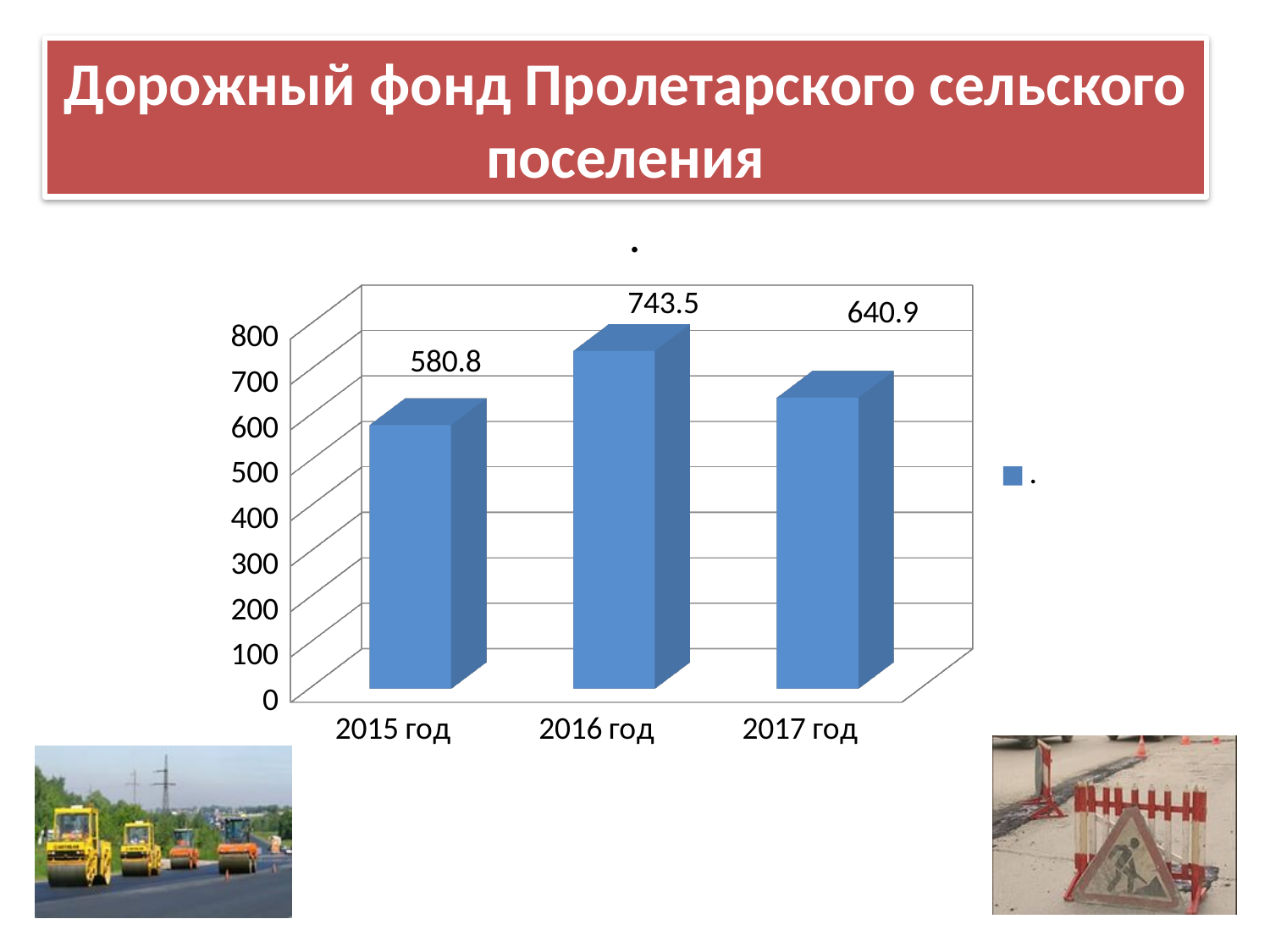
What is the difference between the values for 2016 год and 2017 год? 102.6 Which year has the lowest value? 2015 год Is the value for 2016 год greater or less than 700? greater Which year has the highest value? 2016 год What is the title of the slide? Дорожный фонд Пролетарского сельского поселения What is the value for 2017 год? 640.9 Which is larger, the value for 2017 год or the value for 2015 год? 2017 год What kind of chart is shown on the slide? bar chart How many years are shown on the x axis? 3 What is the difference between the values for 2016 год and 2015 год? 162.7 What is the value for 2016 год? 743.5 What is the value for 2015 год? 580.8